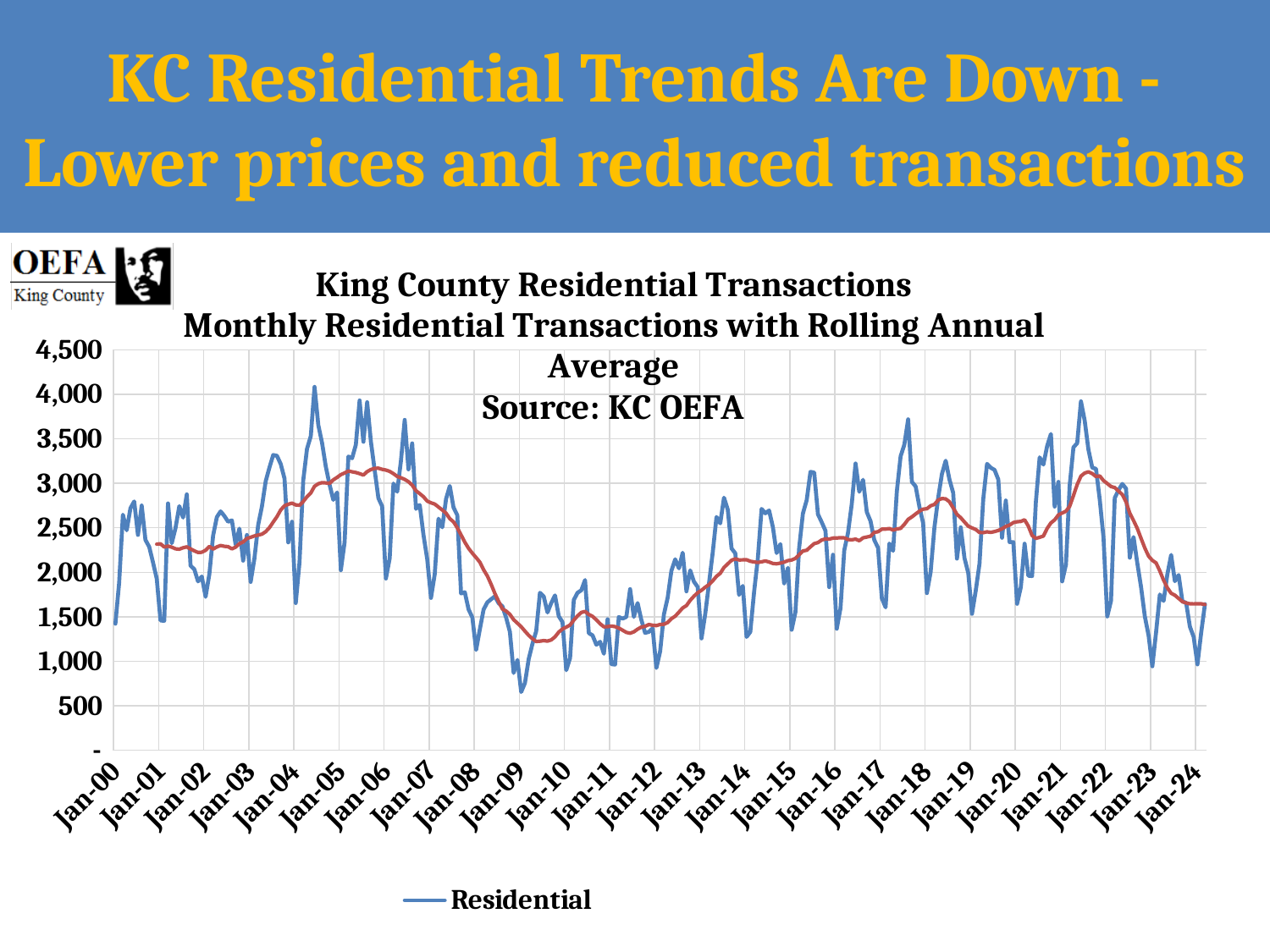
Is the rolling annual average line at Jan-10 greater or less than 1,500? less Does the rolling annual average line rise or fall between Jan-12 and Jan-18? rise Is the peak of the monthly Residential line around Jan-05 greater or less than 3,500? greater How many year labels (Jan-00 through Jan-24) are shown on the x axis? 25 Is the peak of the monthly Residential line around Jan-22 greater or less than 3,500? greater What kind of chart is shown on the slide? Line chart Does the rolling annual average line rise or fall between Jan-22 and Jan-24? fall How many series does the chart legend list? 1 What is the name of the series shown in the chart legend? Residential What source is cited in the chart title? KC OEFA